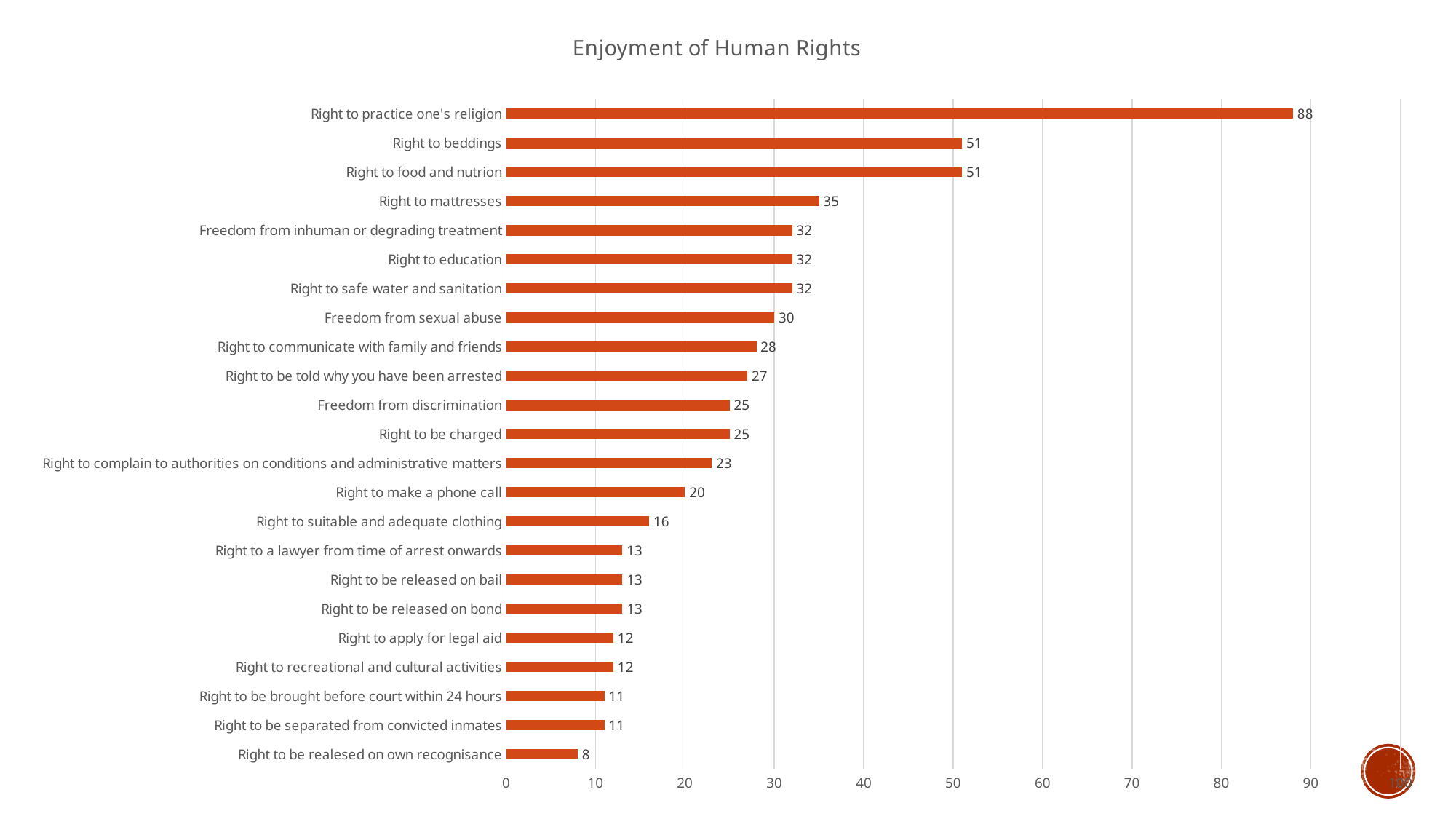
How many categories are shown in the chart? 23 What kind of chart is shown on the slide? Bar chart What is the title of the chart? Enjoyment of Human Rights Which is larger, the value for Freedom from sexual abuse or the value for Right to be charged? Freedom from sexual abuse What is the difference between the values for Right to practice one's religion and Right to beddings? 37 Is the value for Right to food and nutrion greater or less than 40? greater What is the value for Right to practice one's religion? 88 Which category has the lowest value? Right to be realesed on own recognisance What is the value for Right to make a phone call? 20 Which category has the highest value? Right to practice one's religion What is the value for Right to be separated from convicted inmates? 11 What is the difference between the values for Right to mattresses and Right to suitable and adequate clothing? 19